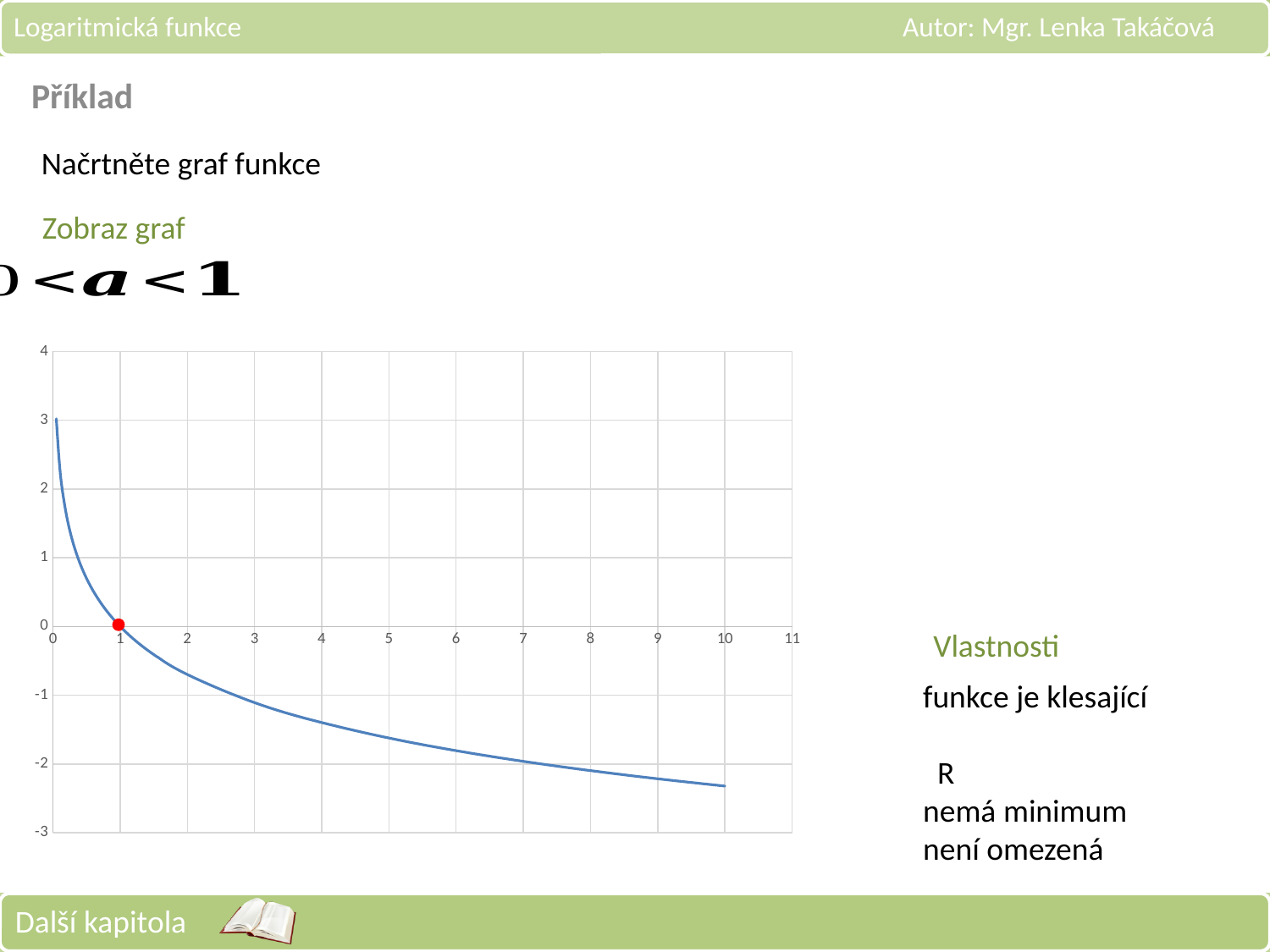
At what x value is the red marked point located? 1 Is the value of the curve at x = 10 greater or less than -2? less What kind of chart is shown on the slide? line chart Do the values of the plotted curve rise or fall as x increases? fall Is the value of the curve at x = 5 greater or less than -1? less What is the highest tick label shown on the x axis? 11 Is the value of the curve at x = 2 larger than its value at x = 8? yes Is the value of the curve at x = 3 greater or less than -2? greater What colour is the plotted curve? blue What is the y value of the red marked point on the curve? 0